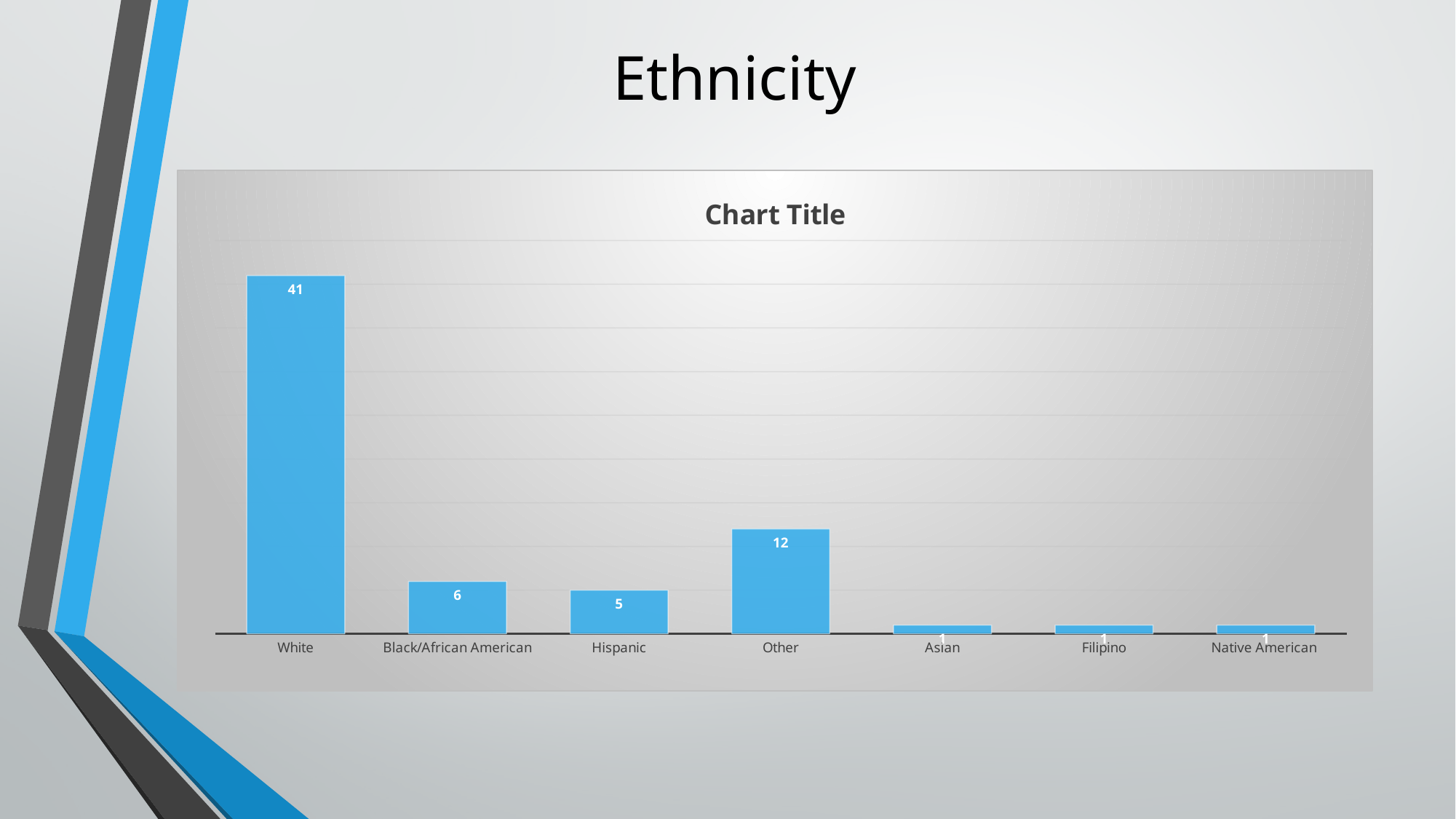
Which is larger, the value for Other or the value for Hispanic? Other Which category has the highest value? White What is the value for Other? 12 What is the difference between the values for White and Other? 29 What is the value for Black/African American? 6 How many categories are shown on the x axis? 7 What is the value for White? 41 What kind of chart is shown on the slide? bar chart What colour are the bars in the chart? blue What is the difference between the values for Black/African American and Hispanic? 1 What is the value for Hispanic? 5 What is the title shown above the chart? Chart Title